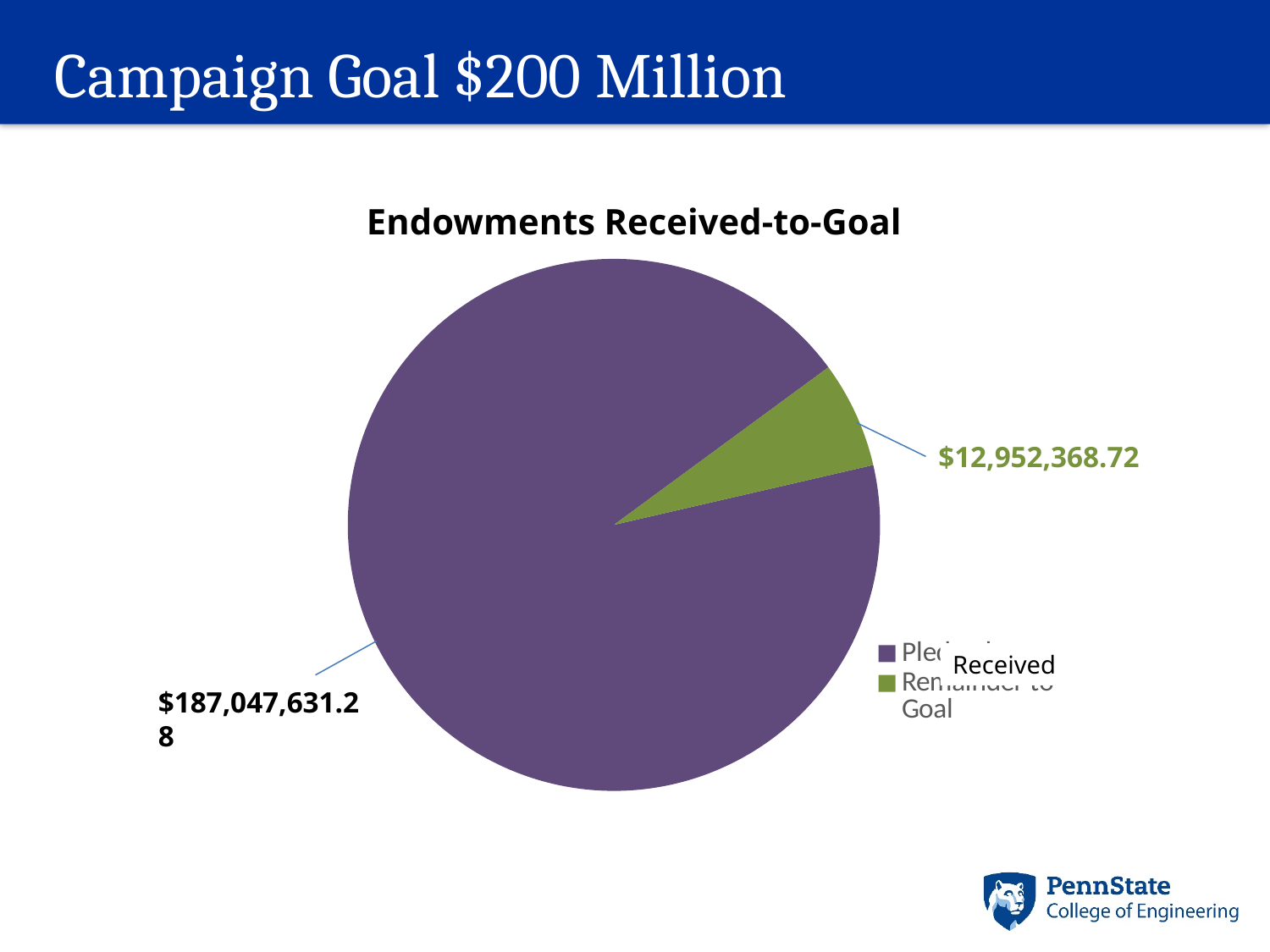
What is the value shown for the Remainder to Goal slice? $12,952,368.72 What colour is the Remainder to Goal slice? Green What is the total of the two slice values in the pie chart? $200,000,000.00 Which slice of the pie chart is the largest? The purple slice ($187,047,631.28) What is the title of the chart? Endowments Received-to-Goal Which slice of the pie chart is the smallest? Remainder to Goal ($12,952,368.72) What is the difference between the two slice values in the pie chart? $174,095,262.56 Is the value of the Remainder to Goal slice greater or less than $20,000,000? less How many slices does the pie chart have? 2 What kind of chart is shown on the slide? Pie chart What is the value shown for the large purple slice of the pie chart? $187,047,631.28 Which is larger: the purple slice or the Remainder to Goal slice? The purple slice